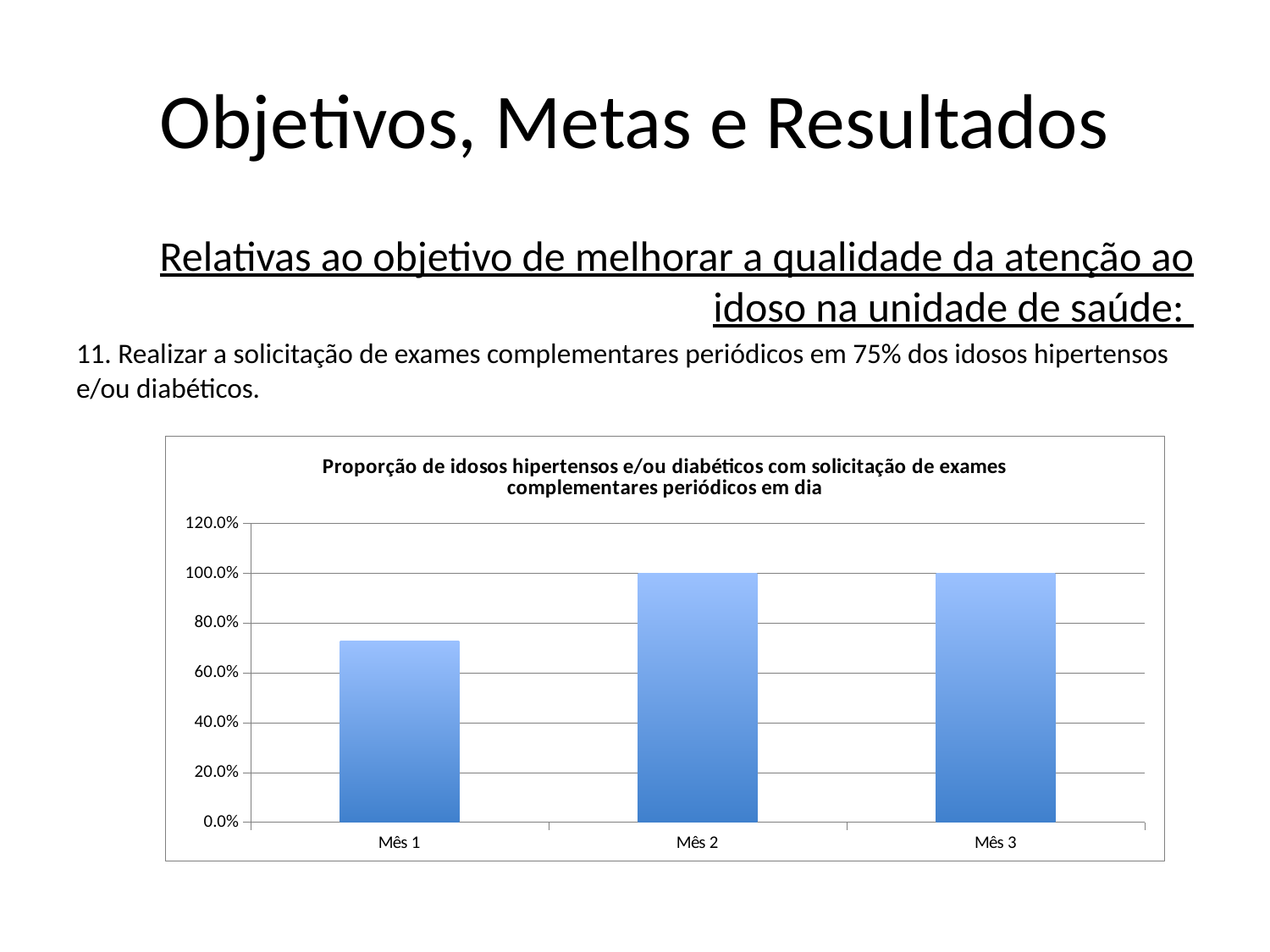
What is the highest value shown on the vertical axis? 120.0% Which is larger, the value for Mês 1 or the value for Mês 2? Mês 2 How many categories (months) are plotted on the chart? 3 Is the value for Mês 1 greater or less than 80.0%? less Is the value for Mês 1 greater or less than 60.0%? greater Does the value rise or fall from Mês 1 to Mês 2? rise What is the value for Mês 2? 100.0% Which month has the lowest value? Mês 1 What kind of chart is shown on the slide? bar chart What is the value for Mês 3? 100.0% What is the title of the chart? Proporção de idosos hipertensos e/ou diabéticos com solicitação de exames complementares periódicos em dia